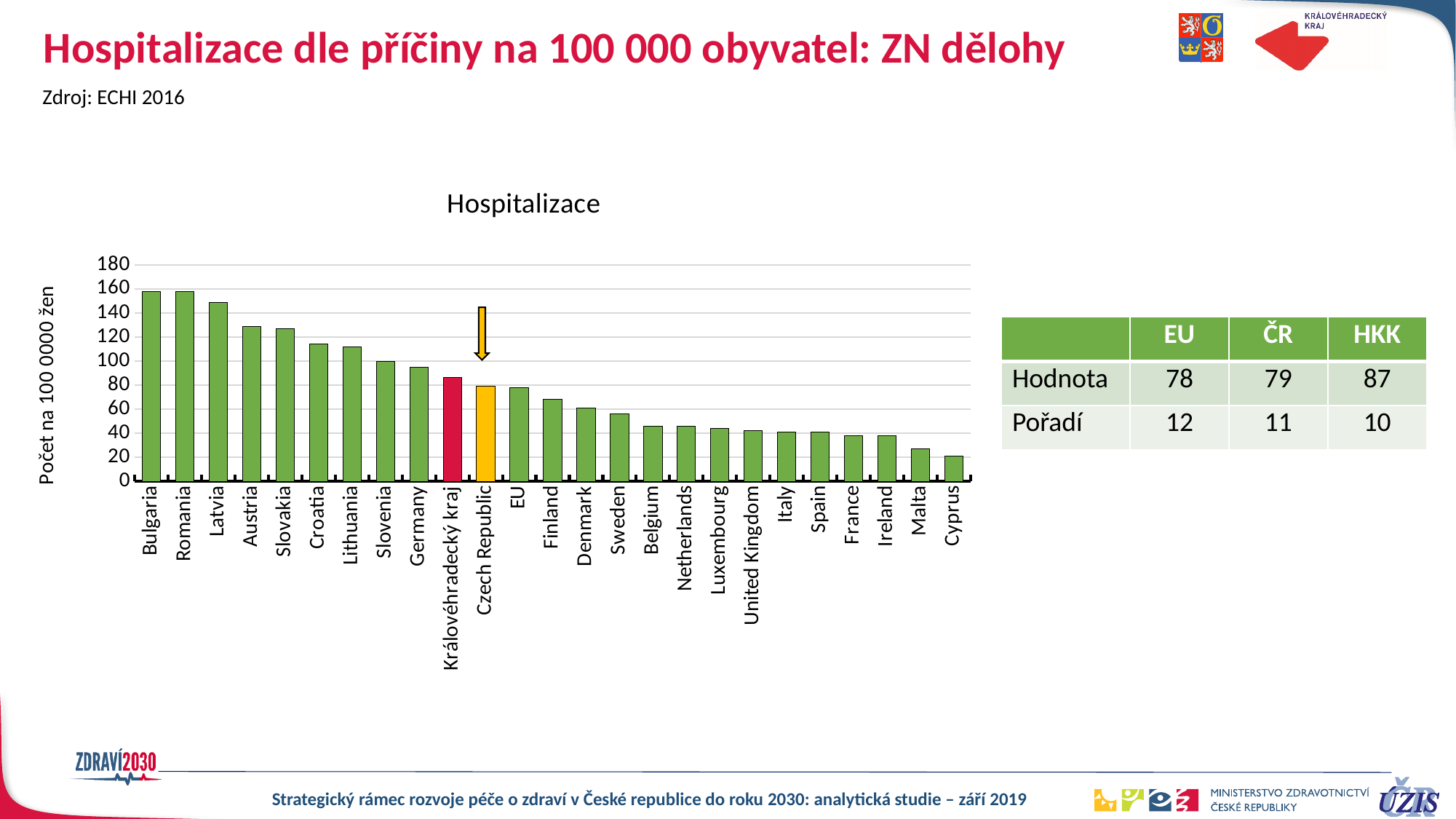
What kind of chart is shown on the slide? bar chart Is the value for Cyprus greater or less than 40? less How many categories (bars) are plotted in the chart? 25 Do the values rise or fall from left to right along the x axis? fall Which has a higher value, Latvia or Austria? Latvia What is the difference between the values for HKK and ČR shown in the table? 8 According to the table, what is the value for Czech Republic (ČR)? 79 Is the value for Bulgaria greater or less than 140? greater According to the table, what is the value for EU? 78 According to the table, what is the value for Královéhradecký kraj (HKK)? 87 What is the title of the chart? Hospitalizace Which category has the lowest value in the chart? Cyprus